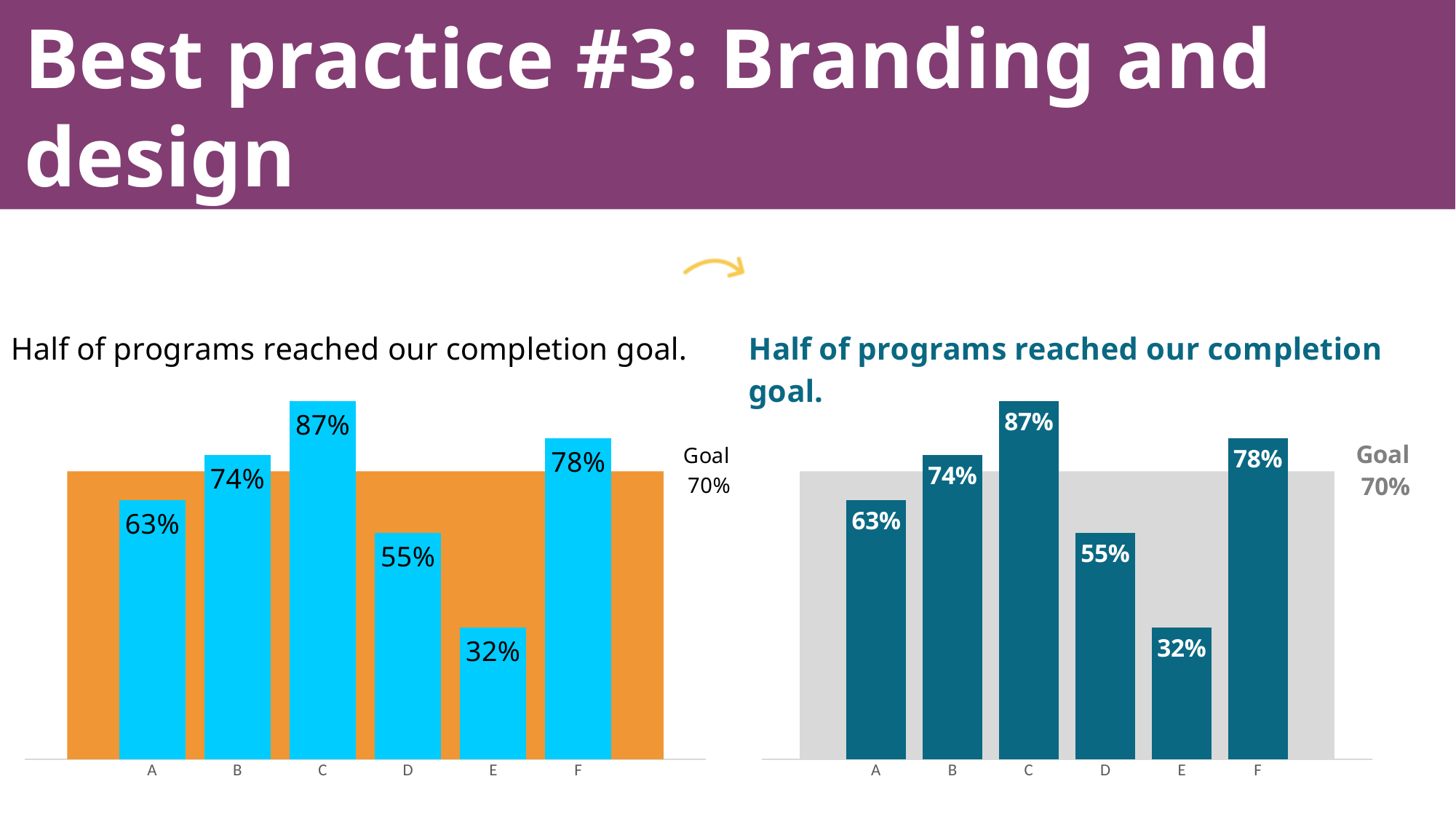
In the left chart, what is the value for program A? 63% In the left chart, what is the difference between the values for program C and program E? 55% In the right chart, what is the difference between the values for program F and program A? 15% In the left chart, what is the value for program C? 87% In the right chart, what goal value is labelled next to the shaded band? 70% In the right chart, which program has the lowest completion value? E What colour are the bars in the left chart? light blue What kind of chart is the right chart? bar chart In the left chart, which program has the highest completion value? C In the right chart, which is larger, the value for program B or the value for program D? B In the left chart, how many programs are shown on the x axis? 6 In the right chart, what is the value for program E? 32%